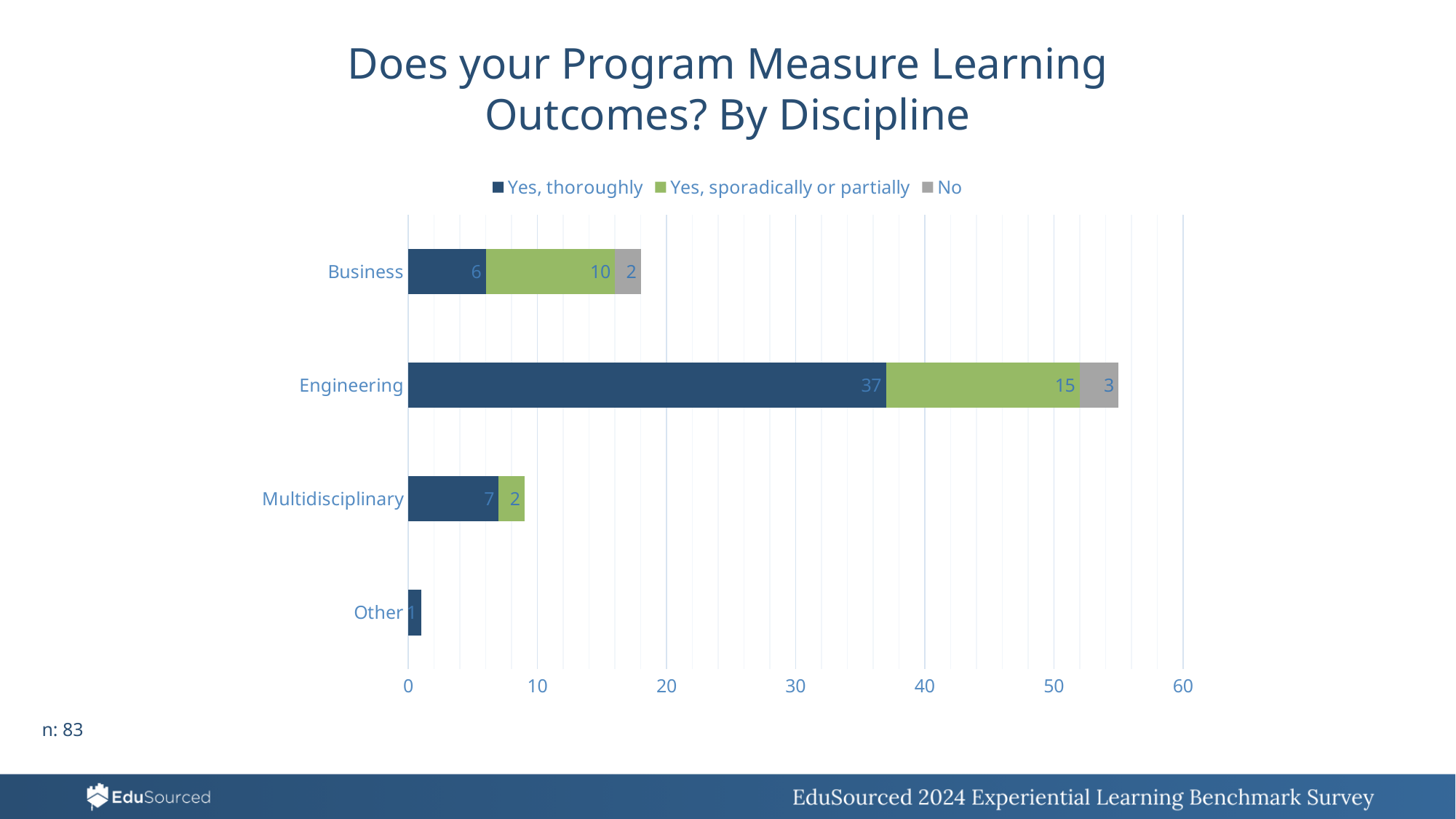
Which discipline has the highest value for "Yes, thoroughly"? Engineering What is the value for "Yes, sporadically or partially" for Business? 10 What is the value for "No" for Engineering? 3 Which discipline has the lowest value for "Yes, thoroughly"? Other How many series does the legend list? 3 What is the total of the stacked bar for Business? 18 What is the value for "Yes, thoroughly" for Engineering? 37 What is the total of the stacked bar for Engineering? 55 Which is larger: the "Yes, thoroughly" value for Multidisciplinary or for Business? Multidisciplinary What is the value for "Yes, thoroughly" for Multidisciplinary? 7 What is the difference between the "Yes, sporadically or partially" values for Engineering and Business? 5 How many disciplines are shown on the chart? 4